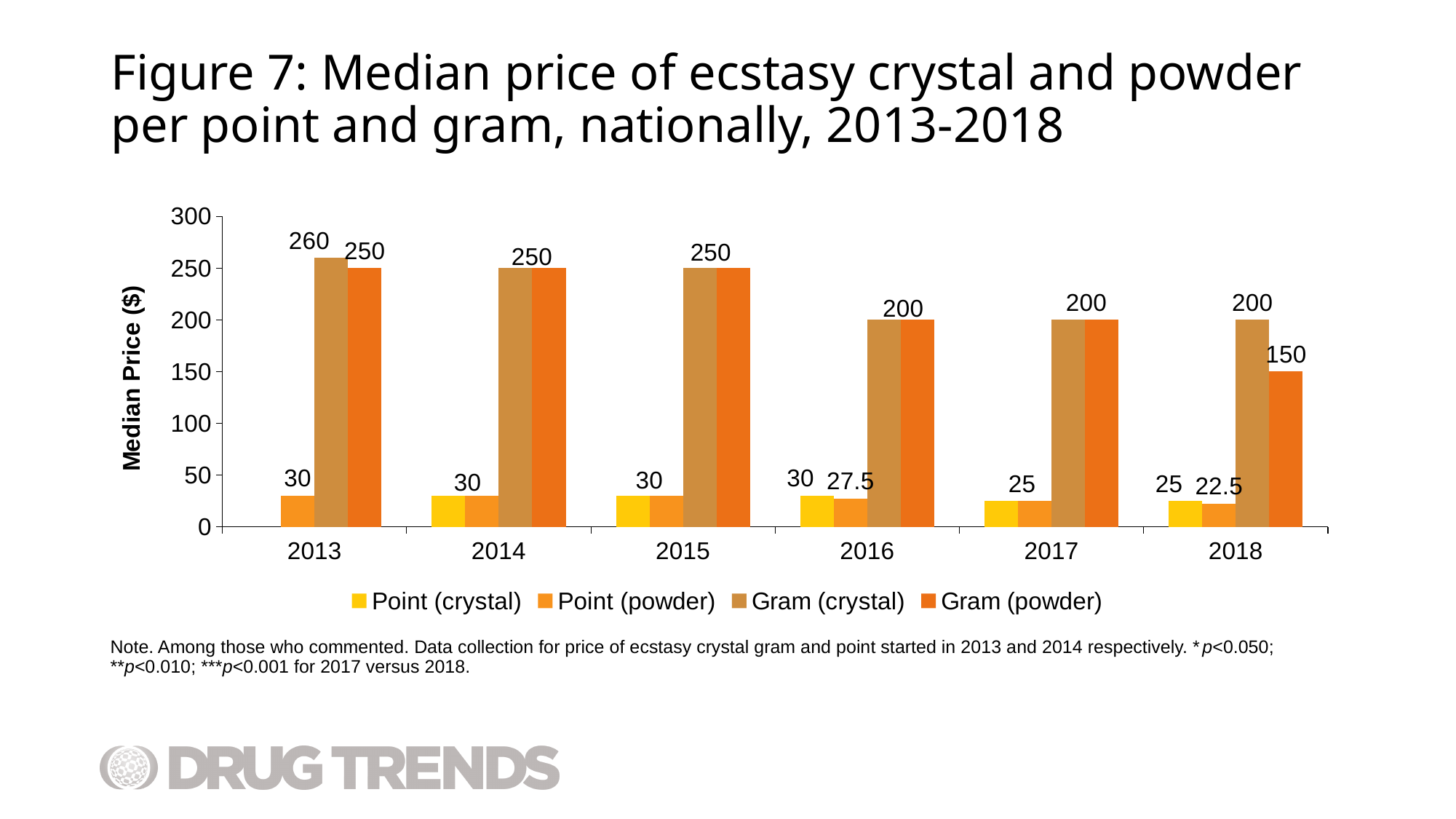
In 2018, which is larger: the Gram (crystal) or the Gram (powder) median price? Gram (crystal) What kind of chart is shown on the slide? Bar chart How many series does the legend list? 4 What is the median price for Point (powder) in 2016? 27.5 What is the median price for Gram (crystal) in 2013? 260 What is the difference between the Gram (crystal) and Gram (powder) median prices in 2018? 50 What is the median price for Point (powder) in 2018? 22.5 In which year is the Gram (powder) median price lowest? 2018 What is the difference between the Gram (crystal) median price in 2013 and in 2018? 60 How many years are shown on the x axis? 6 What is the median price for Gram (powder) in 2018? 150 In which year is the Gram (crystal) median price highest? 2013